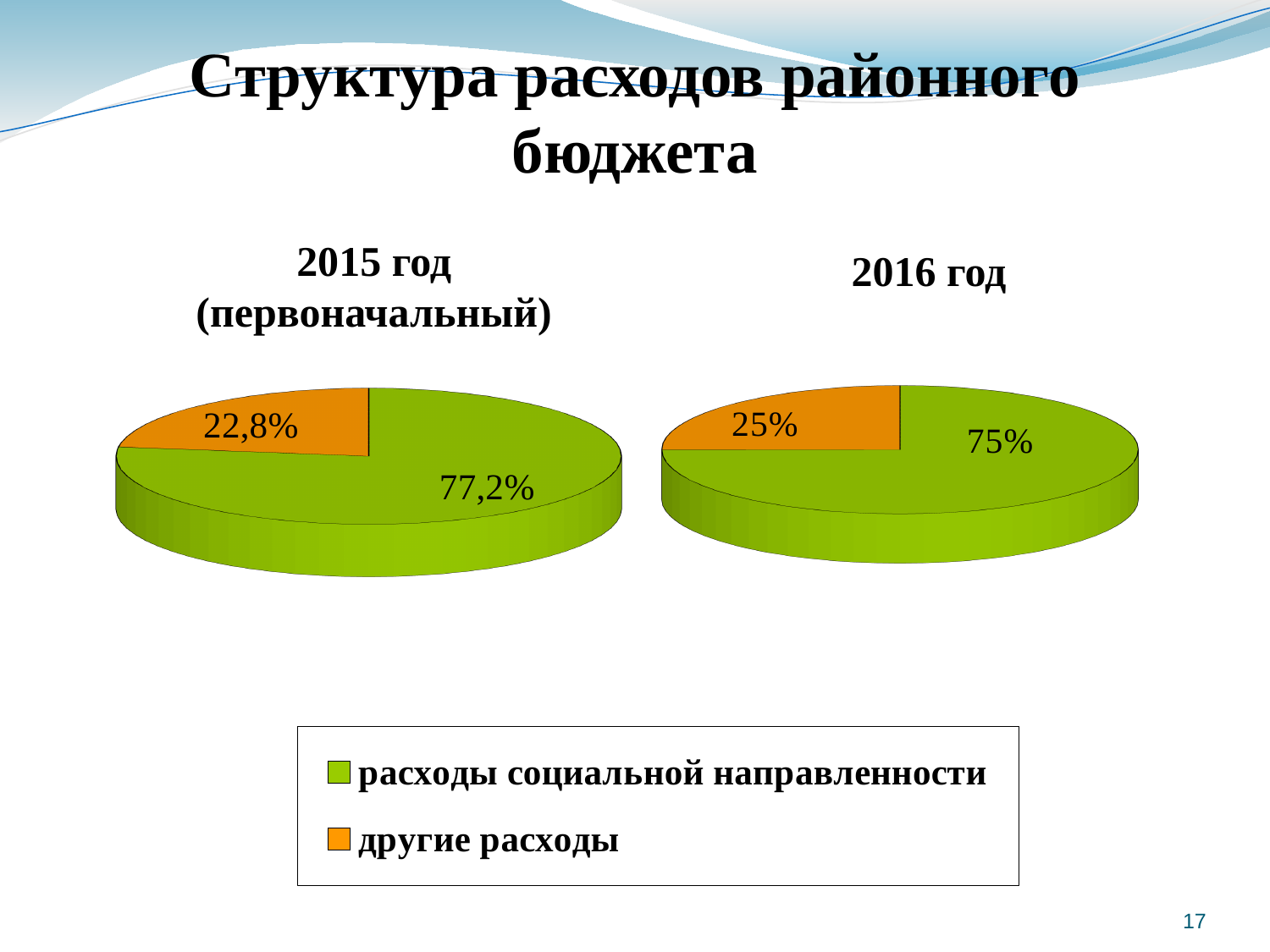
In the 2015 год (первоначальный) chart, what is the difference between the shares of расходы социальной направленности and другие расходы? 54,4% How many entries does the legend list? 2 How many slices does the 2015 год (первоначальный) chart have? 2 In the 2015 год (первоначальный) chart, which category has the largest slice? расходы социальной направленности In the 2015 год (первоначальный) chart, what share is shown for другие расходы? 22,8% In the 2016 год chart, which category has the smallest slice? другие расходы Which is larger: the share of другие расходы in the 2015 год (первоначальный) chart or in the 2016 год chart? 2016 год In the 2016 год chart, what share is shown for другие расходы? 25% In the 2015 год (первоначальный) chart, what share is shown for расходы социальной направленности? 77,2% In the 2016 год chart, what share is shown for расходы социальной направленности? 75% What kind of chart is the 2016 год chart? pie chart What colour represents другие расходы in the legend? orange